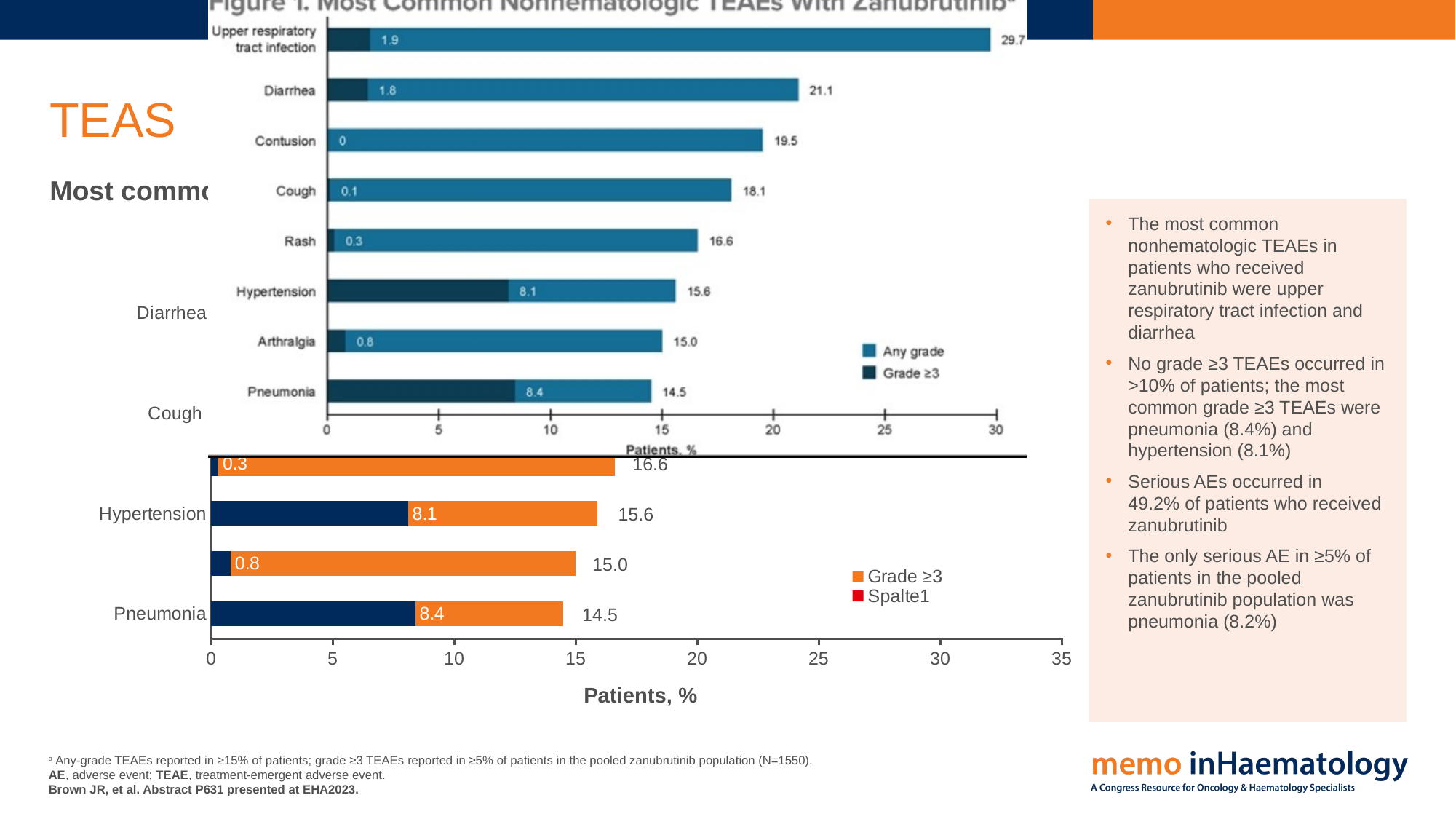
In the top chart (Figure 1), what is the difference between the any-grade values for Upper respiratory tract infection and Diarrhea? 8.6 In the top chart (Figure 1), which has a larger Grade ≥3 value, Pneumonia or Hypertension? Pneumonia In the top chart (Figure 1), what is the label of the x axis? Patients, % What kind of chart is the top chart (Figure 1)? Bar chart In the top chart (Figure 1), what is the Grade ≥3 value for Pneumonia? 8.4 In the top chart (Figure 1), what is the Grade ≥3 value for Hypertension? 8.1 In the top chart (Figure 1. Most Common Nonhematologic TEAEs With Zanubrutinib), what is the any-grade value for Upper respiratory tract infection? 29.7 In the top chart (Figure 1), how many TEAE categories are shown? 8 In the top chart (Figure 1), how many series does the legend list? 2 In the top chart (Figure 1), which TEAE has the lowest any-grade value? Pneumonia In the top chart (Figure 1), which TEAE has the highest any-grade value? Upper respiratory tract infection In the top chart (Figure 1), what is the any-grade value for Contusion? 19.5